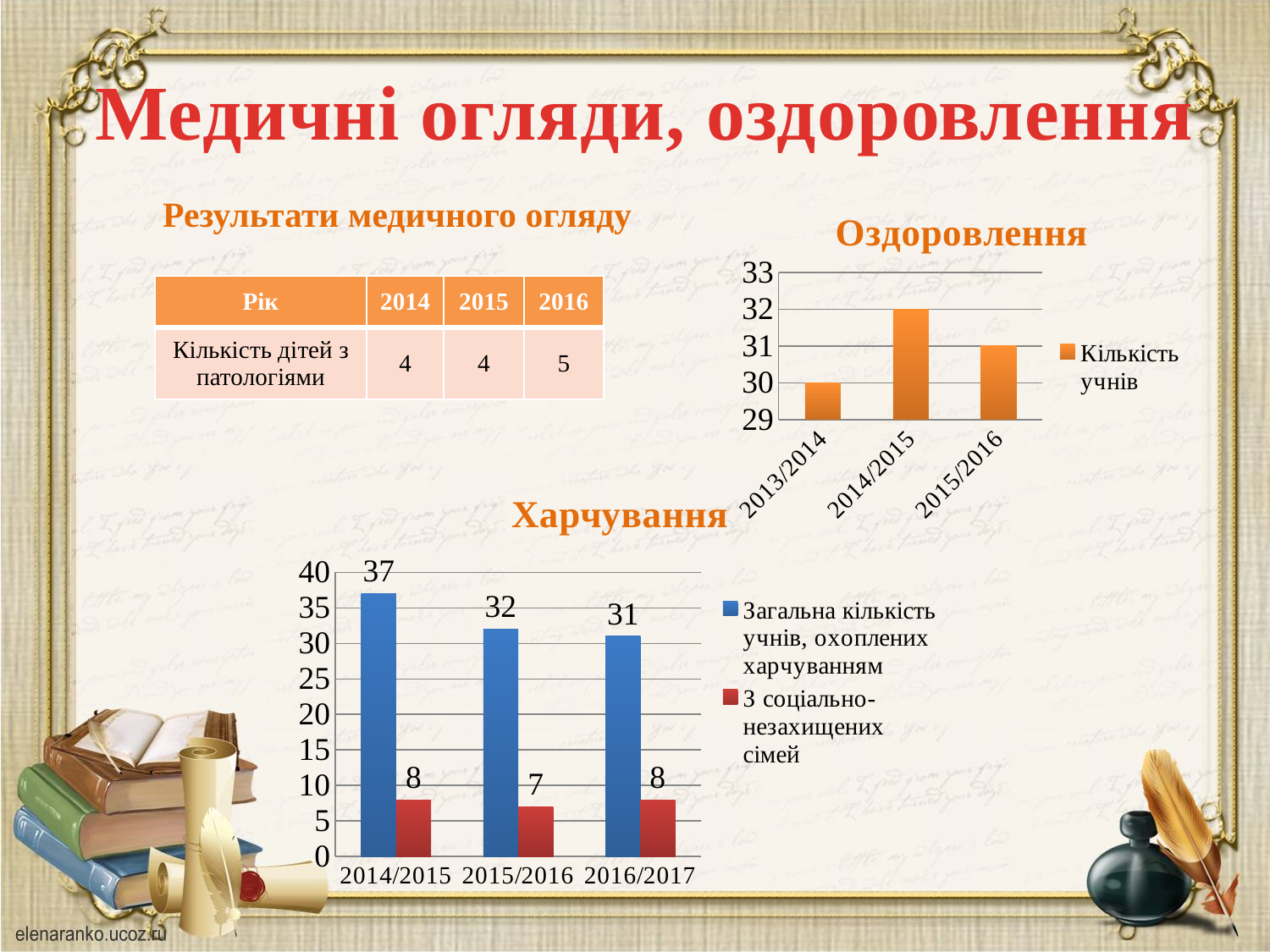
In the "Харчування" chart, which year has the highest value for "Загальна кількість учнів, охоплених харчуванням"? 2014/2015 In the "Харчування" chart, does the "Загальна кількість учнів, охоплених харчуванням" series rise or fall from 2014/2015 to 2016/2017? fall In the "Оздоровлення" chart, is the value for 2015/2016 greater or less than 30? greater In the "Оздоровлення" chart, which category has the lowest value? 2013/2014 In the "Оздоровлення" chart, how many categories are shown on the x axis? 3 In the "Харчування" chart, what is the difference between the "Загальна кількість учнів, охоплених харчуванням" values for 2014/2015 and 2016/2017? 6 In the "Харчування" chart, which is larger: "З соціально-незахищених сімей" for 2014/2015 or for 2015/2016? 2014/2015 In the "Харчування" chart, how many series does the legend list? 2 In the "Оздоровлення" chart, what is the value for 2014/2015? 32 In the "Харчування" chart, what is the value of "З соціально-незахищених сімей" for 2015/2016? 7 What kind of chart is the "Харчування" chart? bar chart In the "Харчування" chart, what is the value of "Загальна кількість учнів, охоплених харчуванням" for 2014/2015? 37